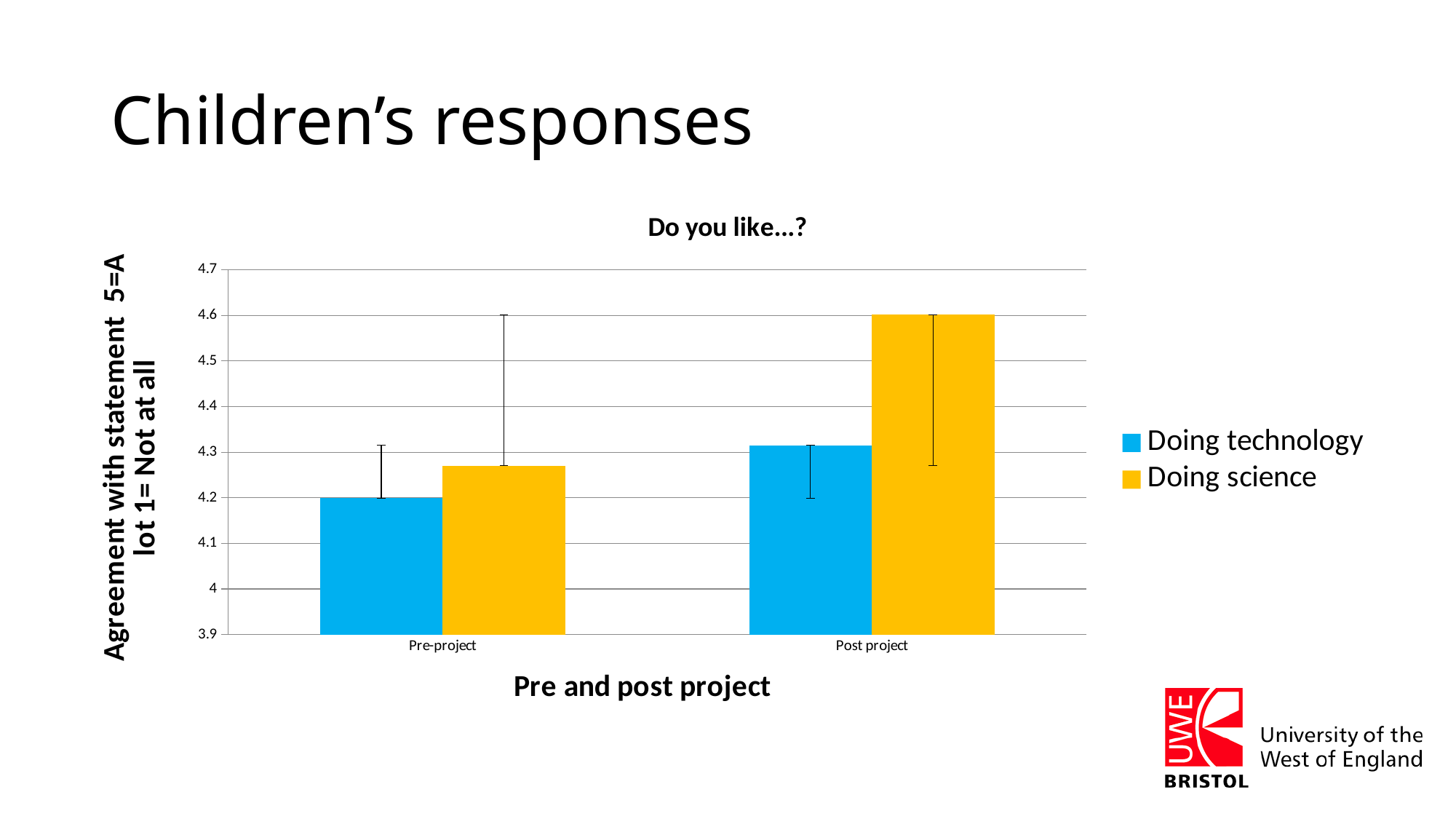
Which bar is the lowest in the chart? Doing technology, Pre-project How many series does the legend list? 2 How many categories are shown on the x axis? 2 Do the Doing science values rise or fall from Pre-project to Post project? Rise What is the value for Doing technology in the Pre-project category? 4.2 Is the value for Doing technology in the Post project category greater or less than 4.4? less Which bar is the highest in the chart? Doing science, Post project What is the difference between the Doing science value for Post project and the Doing technology value for Pre-project? 0.4 What is the title of the chart? Do you like...? What type of chart is shown on the slide? Bar chart In the Post project category, which series has the larger value, Doing technology or Doing science? Doing science What is the value for Doing science in the Post project category? 4.6